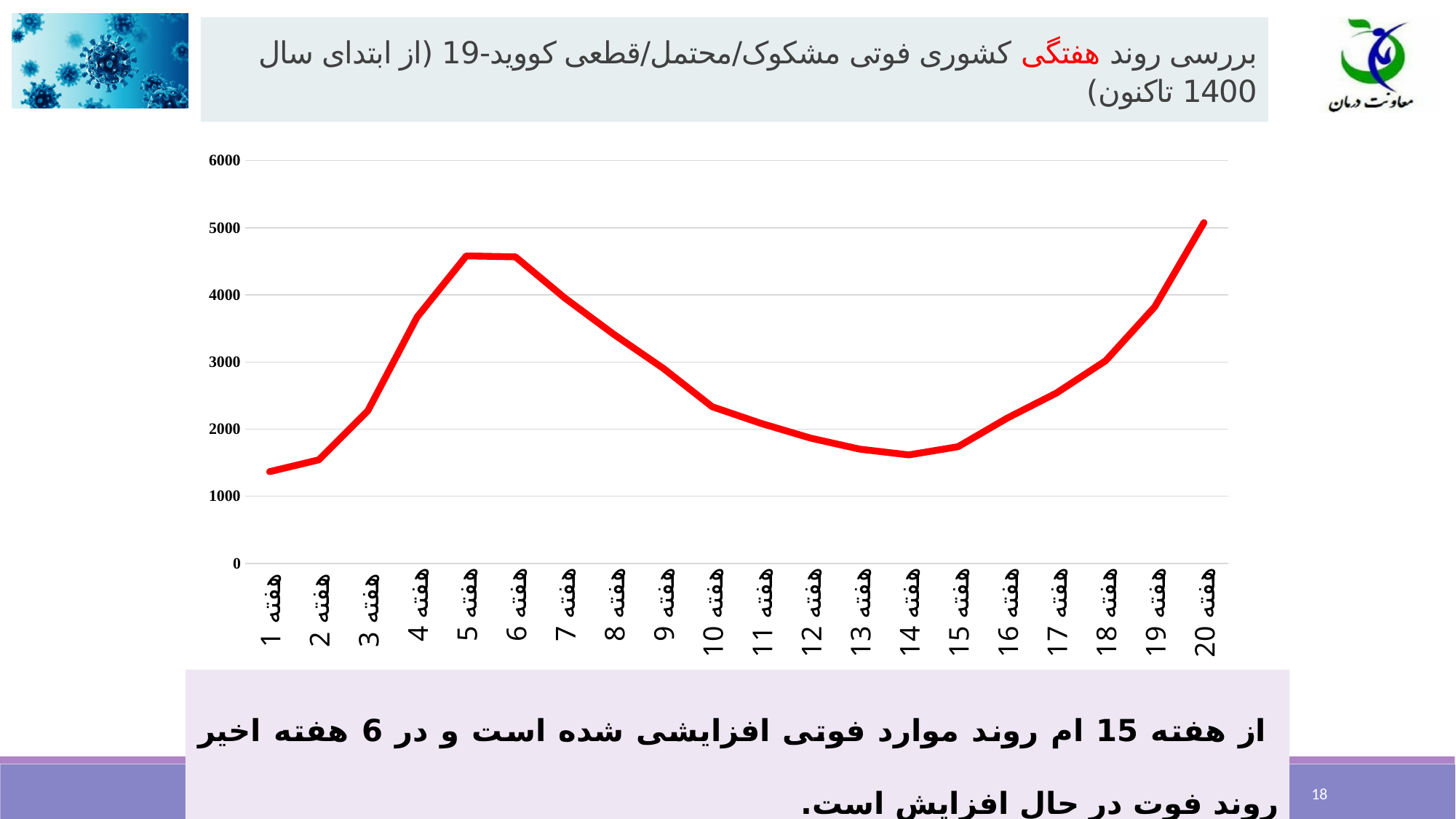
Is the value for هفته 10 greater or less than 2000? greater Which is larger, the value for هفته 7 or the value for هفته 10? هفته 7 Do the values rise or fall from هفته 15 to هفته 20? rise Is the value for هفته 5 greater or less than 5000? less Is the value for هفته 8 greater or less than 3000? greater How many weeks (data points) are plotted along the x axis? 20 Which week has the lowest value on the chart? هفته 1 What kind of chart is shown on the slide? line chart Which week has the highest value on the chart? هفته 20 Do the values rise or fall from هفته 6 to هفته 14? fall